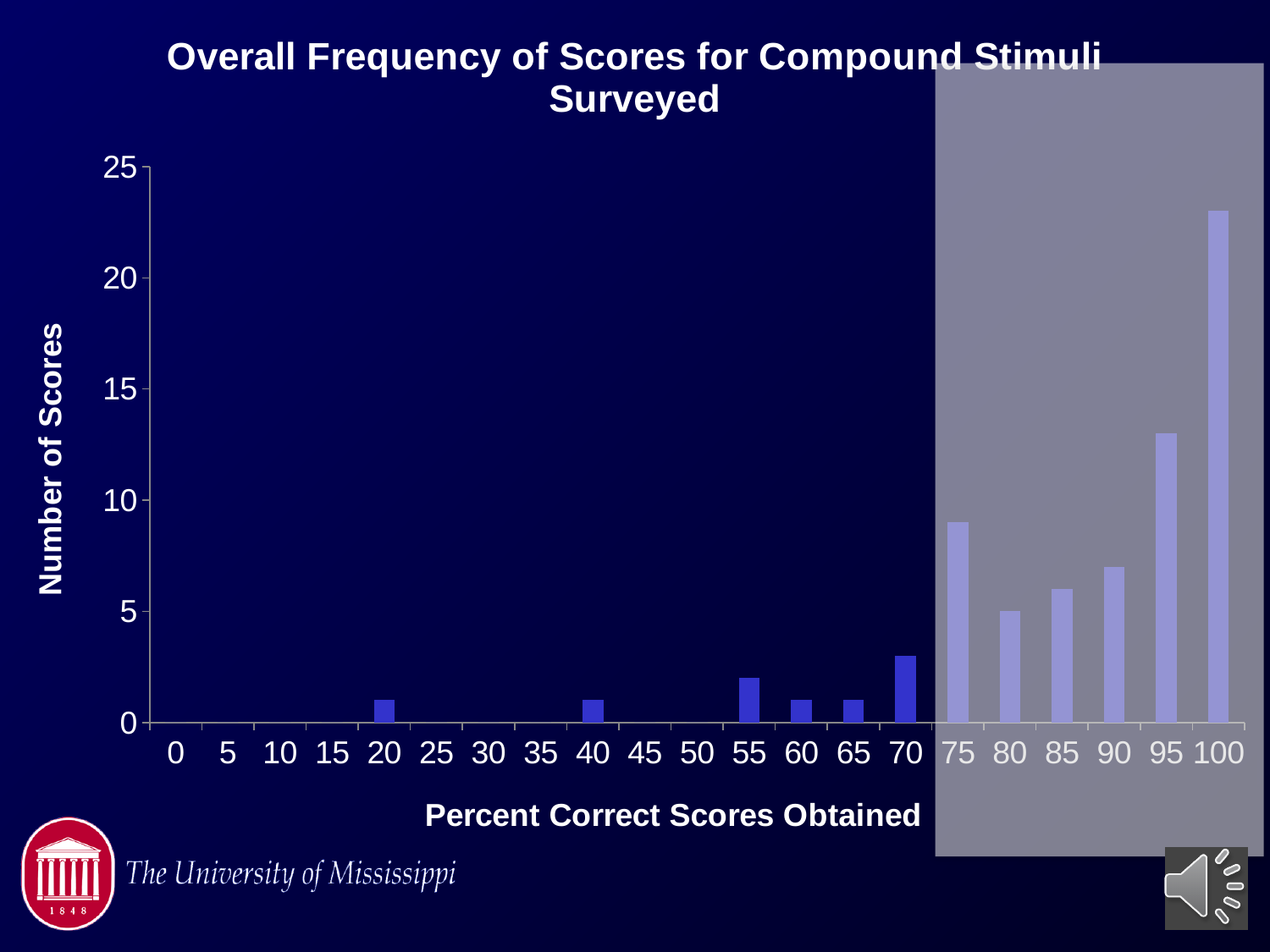
Which has more scores, 75 percent correct or 80 percent correct? 75 Is the number of scores for 95 percent correct greater or less than 10? greater What kind of chart is shown on the slide? bar chart Is the number of scores for 70 percent correct greater or less than 5? less Which has more scores, 95 percent correct or 100 percent correct? 100 Is the number of scores for 75 percent correct greater or less than 10? less From 80 percent correct to 100 percent correct, do the number of scores rise or fall? rise Which percent-correct score has the highest number of scores? 100 What is the title of the chart? Overall Frequency of Scores for Compound Stimuli Surveyed How many percent-correct categories are labelled on the x axis? 21